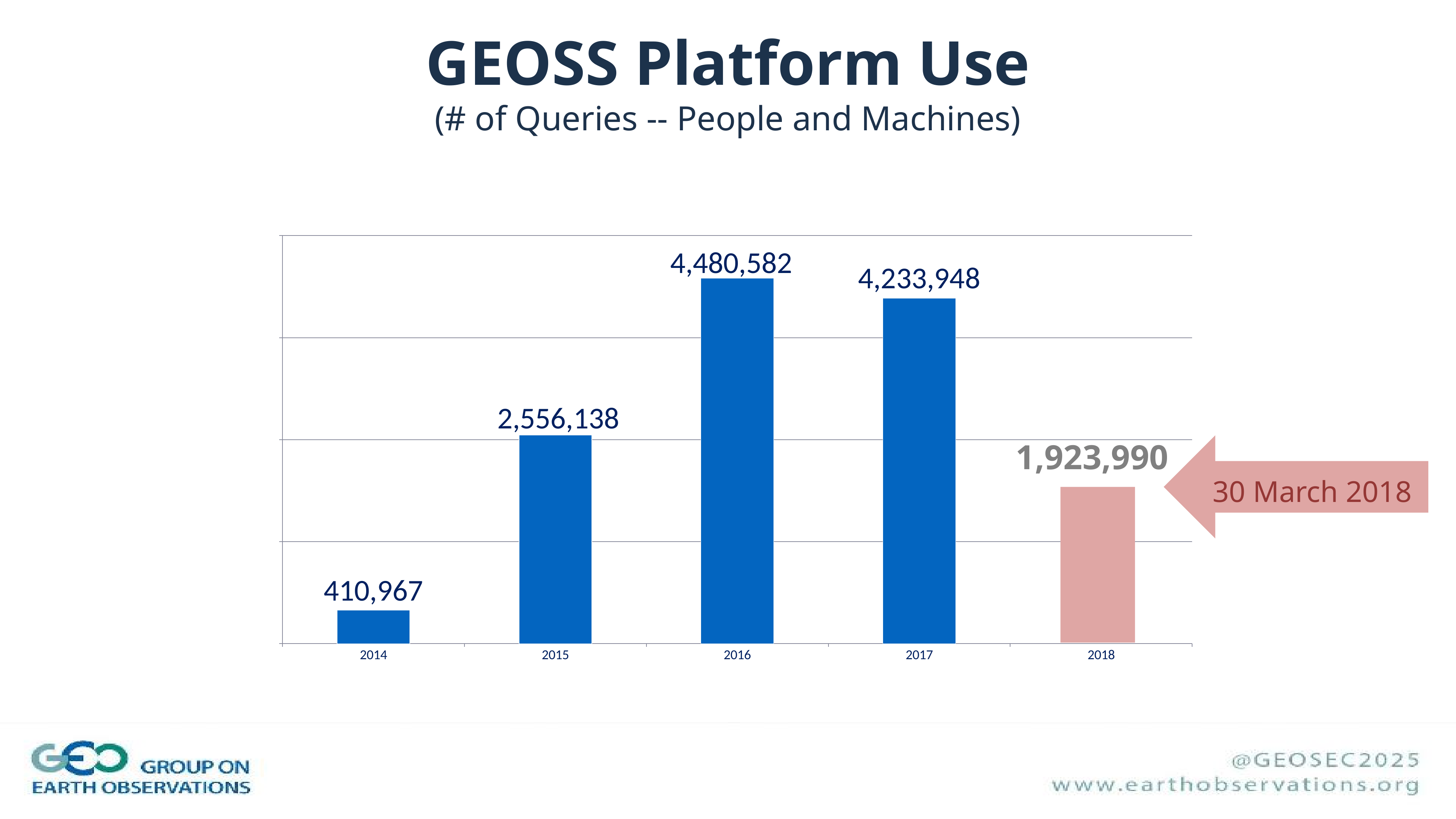
What date does the arrow annotation next to the 2018 bar give? 30 March 2018 What is the difference in queries between 2016 and 2017? 246,634 How many years are shown on the x axis? 5 What value is shown for 2018 (as of 30 March 2018)? 1,923,990 By how much did the number of queries increase from 2014 to 2015? 2,145,171 What kind of chart is shown on the slide? Bar chart Do the values rise or fall from 2014 to 2016? Rise What is the number of queries for 2016? 4,480,582 Which year has the highest number of queries? 2016 Which year had more queries, 2015 or 2017? 2017 What is the number of queries for 2014? 410,967 Which year has the lowest number of queries? 2014